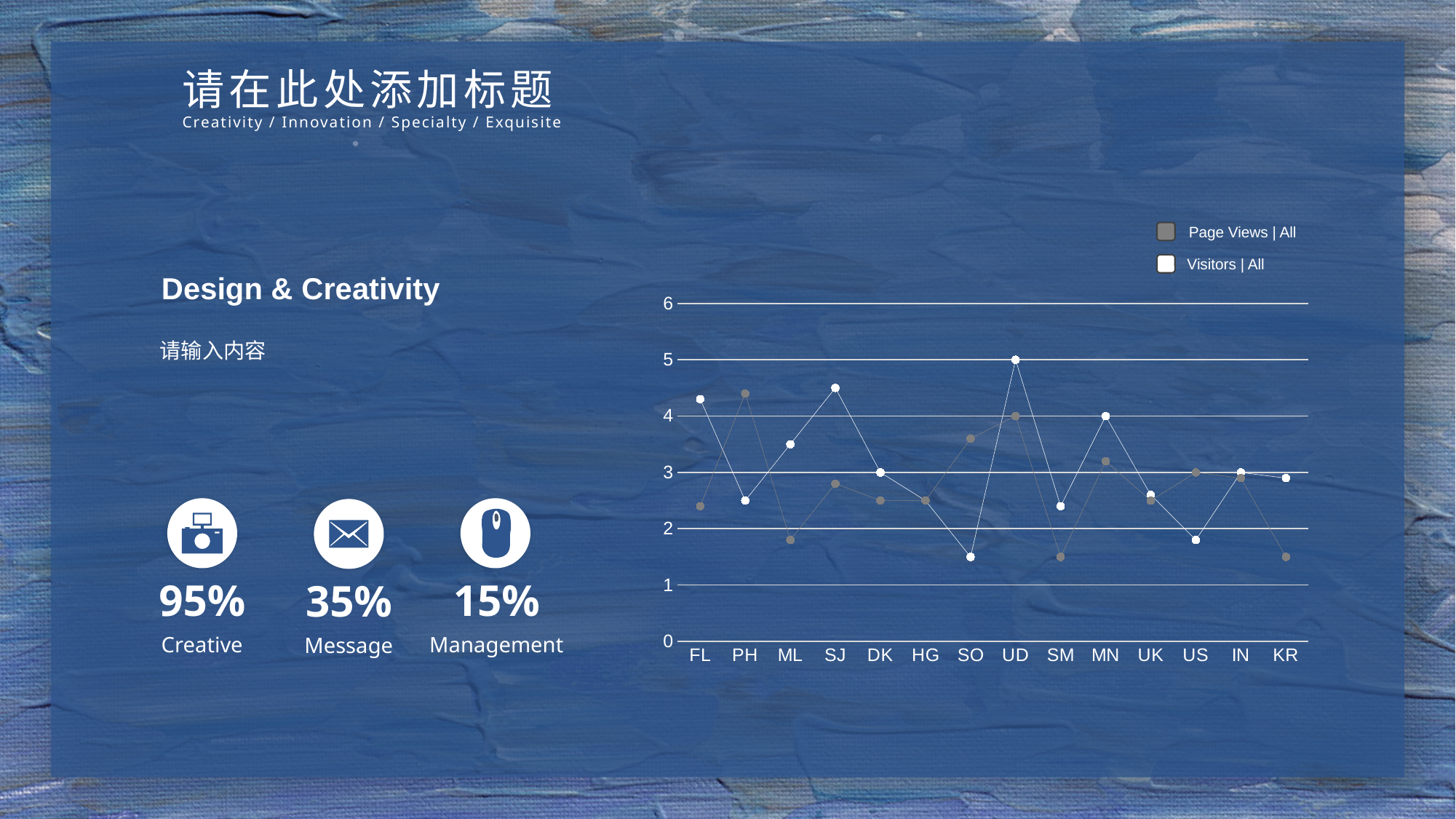
Which category has the highest value for Visitors | All? UD How many categories are shown along the x axis of the chart? 14 Which category has the lowest value for Visitors | All? SO Is the value for Visitors | All at SJ greater or less than 4? greater Which category has the highest value for Page Views | All? PH At PH, which series has the larger value, Page Views | All or Visitors | All? Page Views | All What is the value of Page Views | All at UD? 4 What is the value of Visitors | All at DK? 3 What kind of chart is shown on the slide? line chart What is the value of Visitors | All at UD? 5 What are the two series named in the chart legend? Page Views | All and Visitors | All How many series does the chart legend list? 2